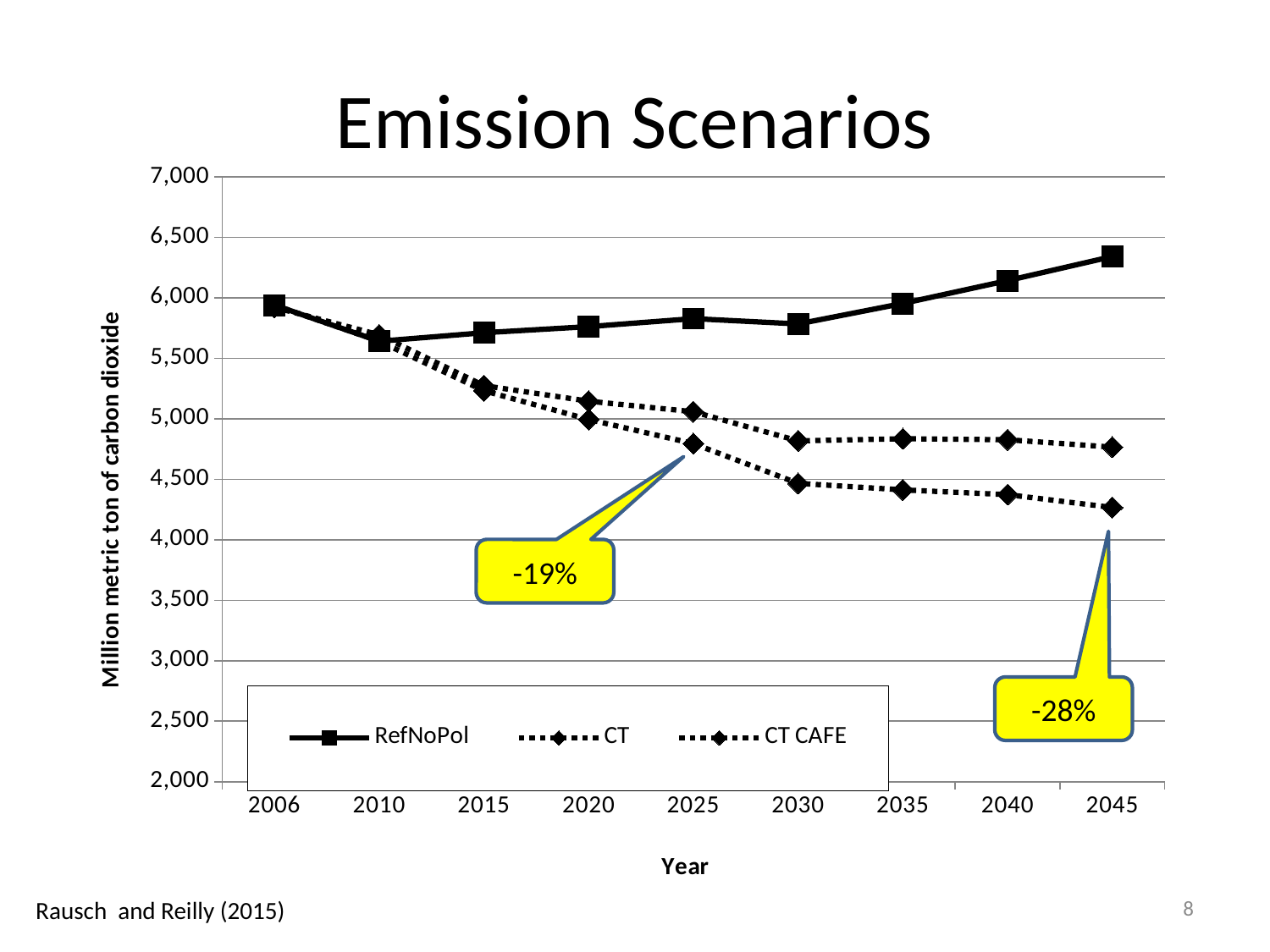
Which series has the highest value in 2045? RefNoPol How many series does the legend list? 3 What kind of chart is shown on the slide? line chart Which series has the lowest value in 2030? CT CAFE Is the value for CT CAFE in 2045 greater or less than 4,500? less What is the title of the chart? Emission Scenarios Does the CT CAFE series rise or fall between 2006 and 2045? fall Does the RefNoPol series rise or fall between 2010 and 2045? rise Is the value for RefNoPol in 2045 greater or less than 6,000? greater In 2040, which is larger, CT or CT CAFE? CT How many years are shown on the x axis? 9 Is the value for CT in 2045 greater or less than 5,000? less